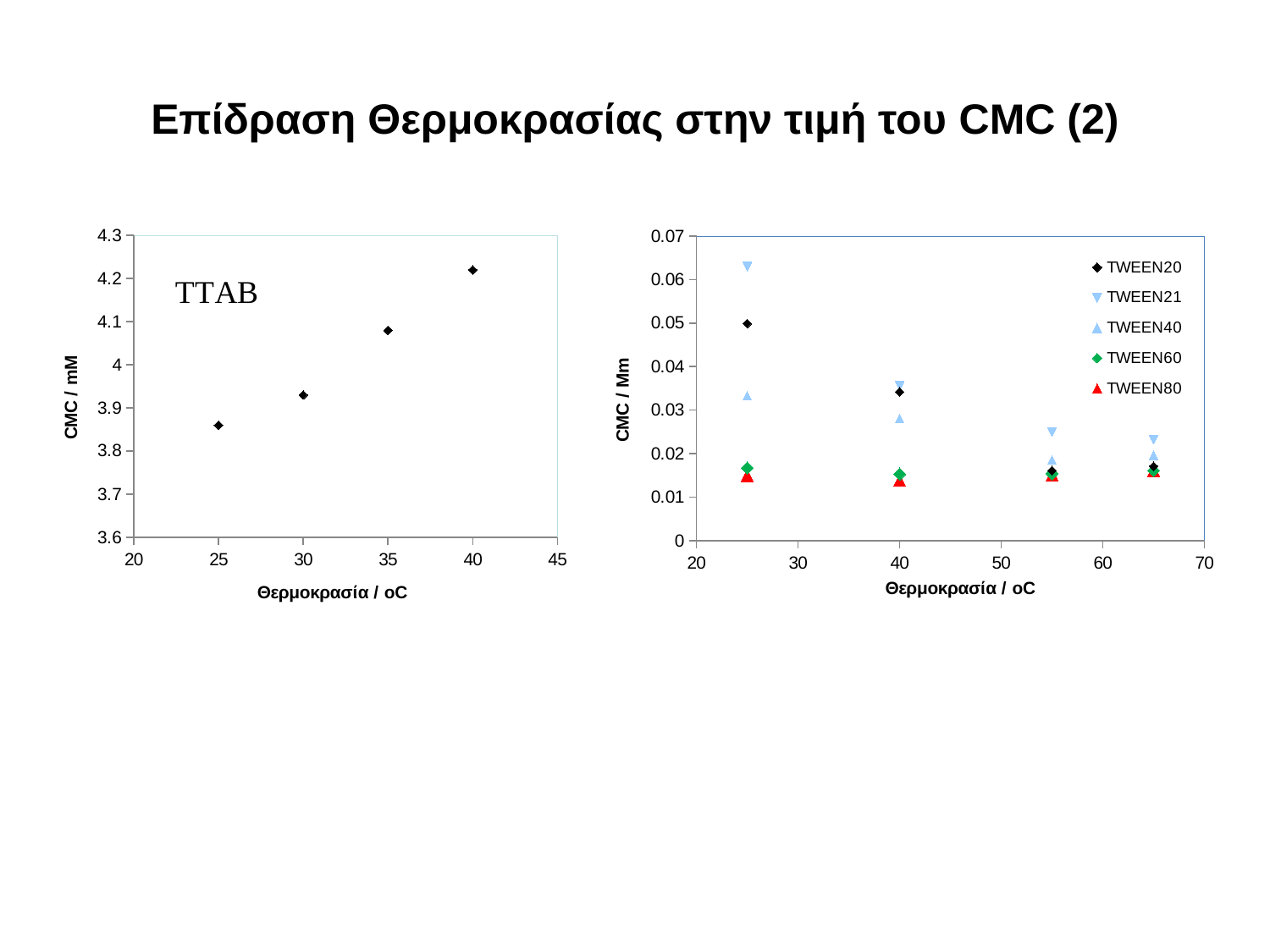
On the left chart (TTAB), is the CMC value at 25 °C greater or less than 3.9? less How many series does the legend of the right chart list? 5 How many data points are plotted on the left chart (TTAB)? 4 On the right chart, does the CMC value of TWEEN20 rise or fall as temperature increases? fall On the right chart, which series has the lowest CMC value at 25 °C? TWEEN80 On the left chart (TTAB), is the CMC value at 35 °C greater or less than 4? greater On the right chart, is the CMC value of TWEEN21 at 25 °C greater or less than 0.06? greater On the right chart, which series has the highest CMC value at 25 °C? TWEEN21 On the left chart (TTAB), at which temperature is the CMC value highest? 40 On the right chart, which is larger at 40 °C: the CMC value of TWEEN40 or TWEEN60? TWEEN40 On the left chart (TTAB), do the CMC values rise or fall as temperature increases? rise What kind of chart is the left chart (TTAB)? scatter chart